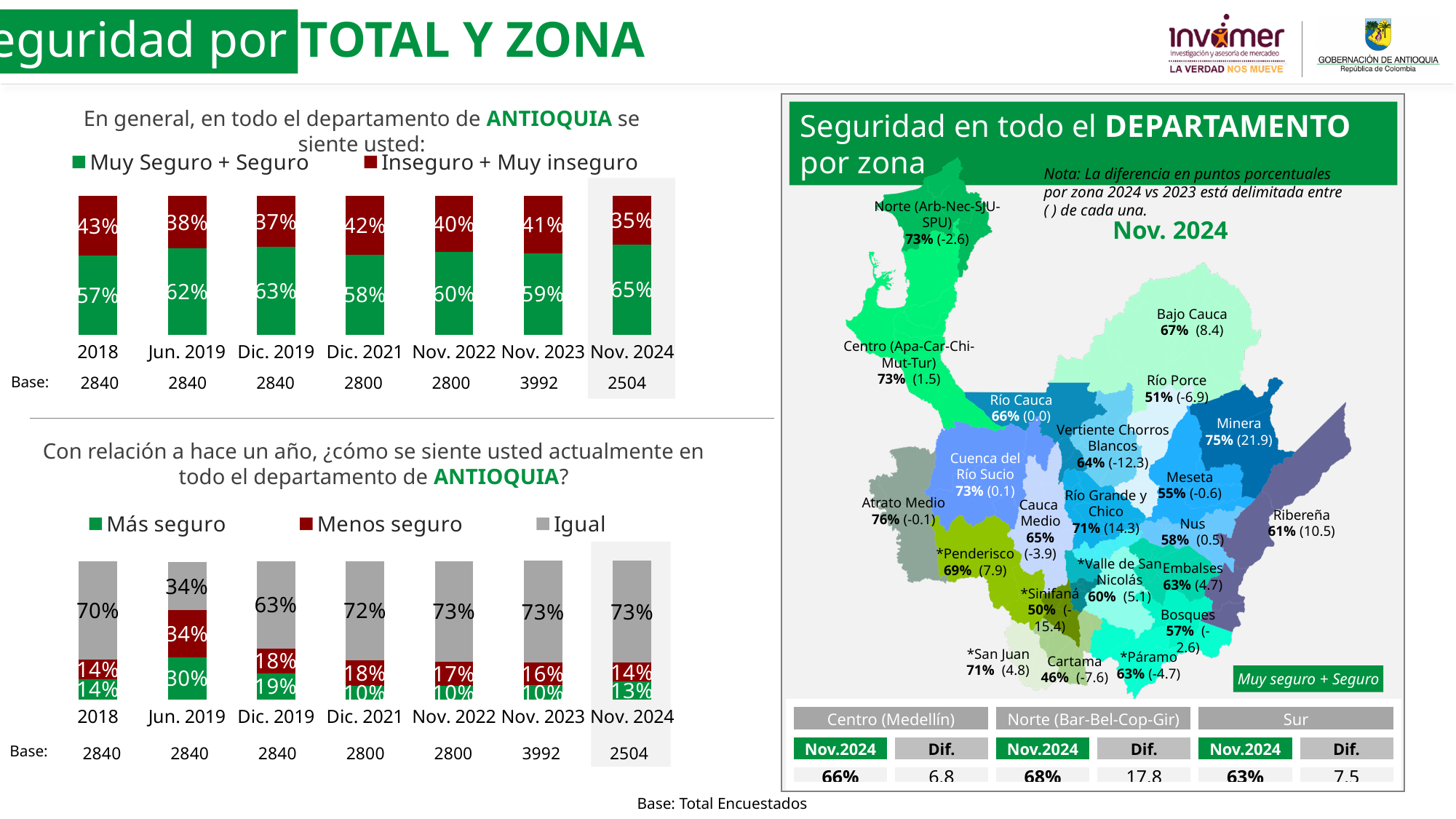
In the top chart, how many series does the legend list? 2 In the bottom chart, what is the value of Más seguro for Nov. 2024? 13% In the bottom chart, is the Menos seguro value for 2018 larger or smaller than the Menos seguro value for Jun. 2019? smaller In the top chart, which period has the lowest Muy Seguro + Seguro value? 2018 What type of chart is used for the two charts on the left of the slide? Stacked bar chart In the top chart, what is the value of Inseguro + Muy inseguro for Dic. 2021? 42% In the top chart, which period has the highest Muy Seguro + Seguro value? Nov. 2024 In the bottom chart, which period has the highest Más seguro value? Jun. 2019 In the top chart ('En general, en todo el departamento de ANTIOQUIA se siente usted'), what is the value of Muy Seguro + Seguro for Nov. 2024? 65% In the bottom chart ('Con relación a hace un año...'), what is the value of Igual for Jun. 2019? 34% In the top chart, how many time periods are shown on the x axis? 7 In the top chart, what is the difference in percentage points between Muy Seguro + Seguro in Nov. 2024 and Nov. 2023? 6